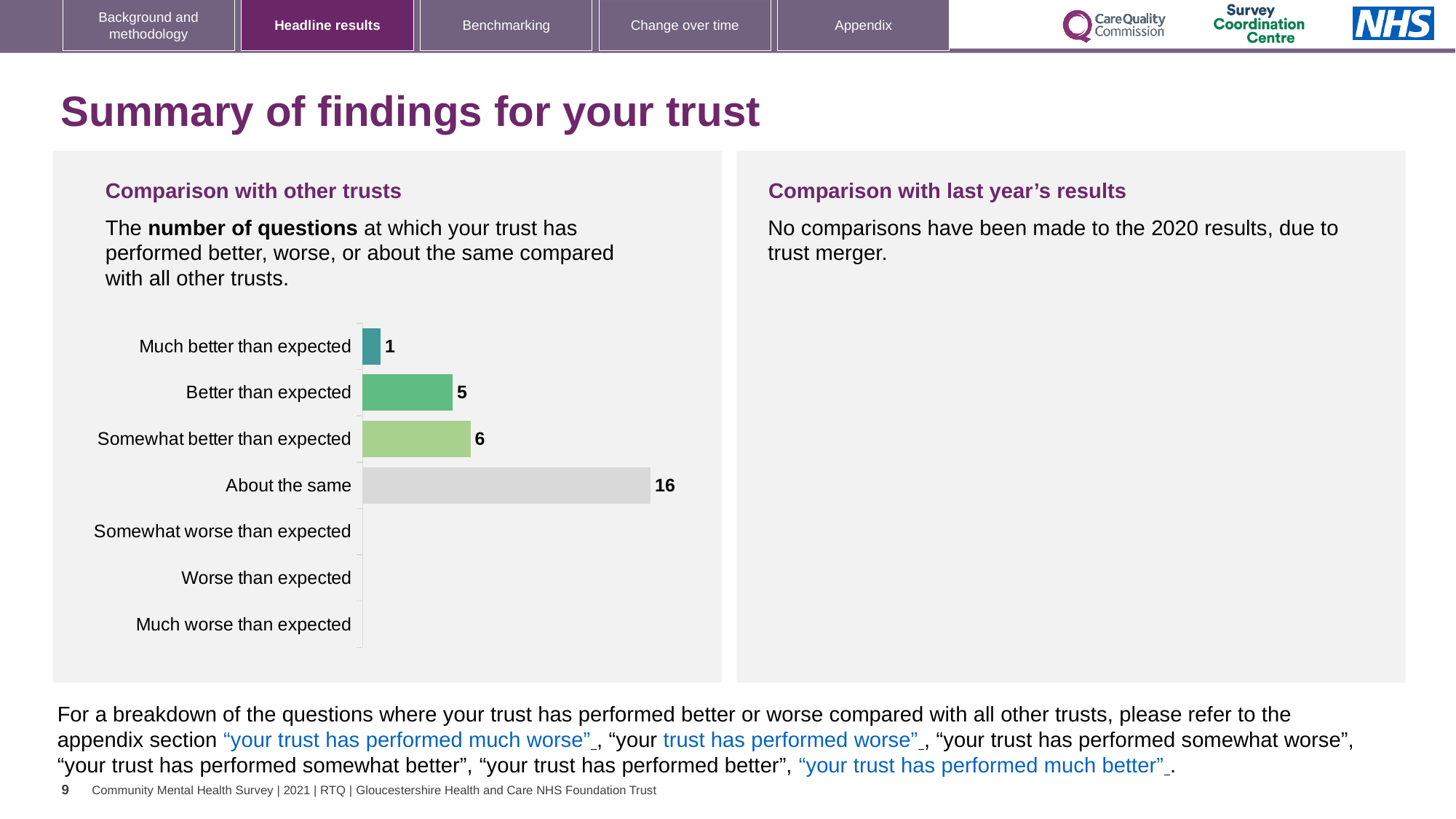
What is the difference between the 'About the same' value and the 'Somewhat better than expected' value? 10 Which categories on the chart have no bar shown? Somewhat worse than expected, Worse than expected, Much worse than expected What is the total number of questions across the 'Much better', 'Better' and 'Somewhat better than expected' categories? 12 How many questions fall into the 'About the same' category? 16 Which is larger, the value for 'Better than expected' or the value for 'Somewhat better than expected'? Somewhat better than expected What is the value for 'Somewhat better than expected'? 6 What kind of chart is shown on the slide? Bar chart Which category has the highest number of questions? About the same What is the value for 'Much better than expected'? 1 What is the value for 'Better than expected'? 5 How many categories are listed on the chart's axis? 7 What colour is the bar for 'About the same'? Grey